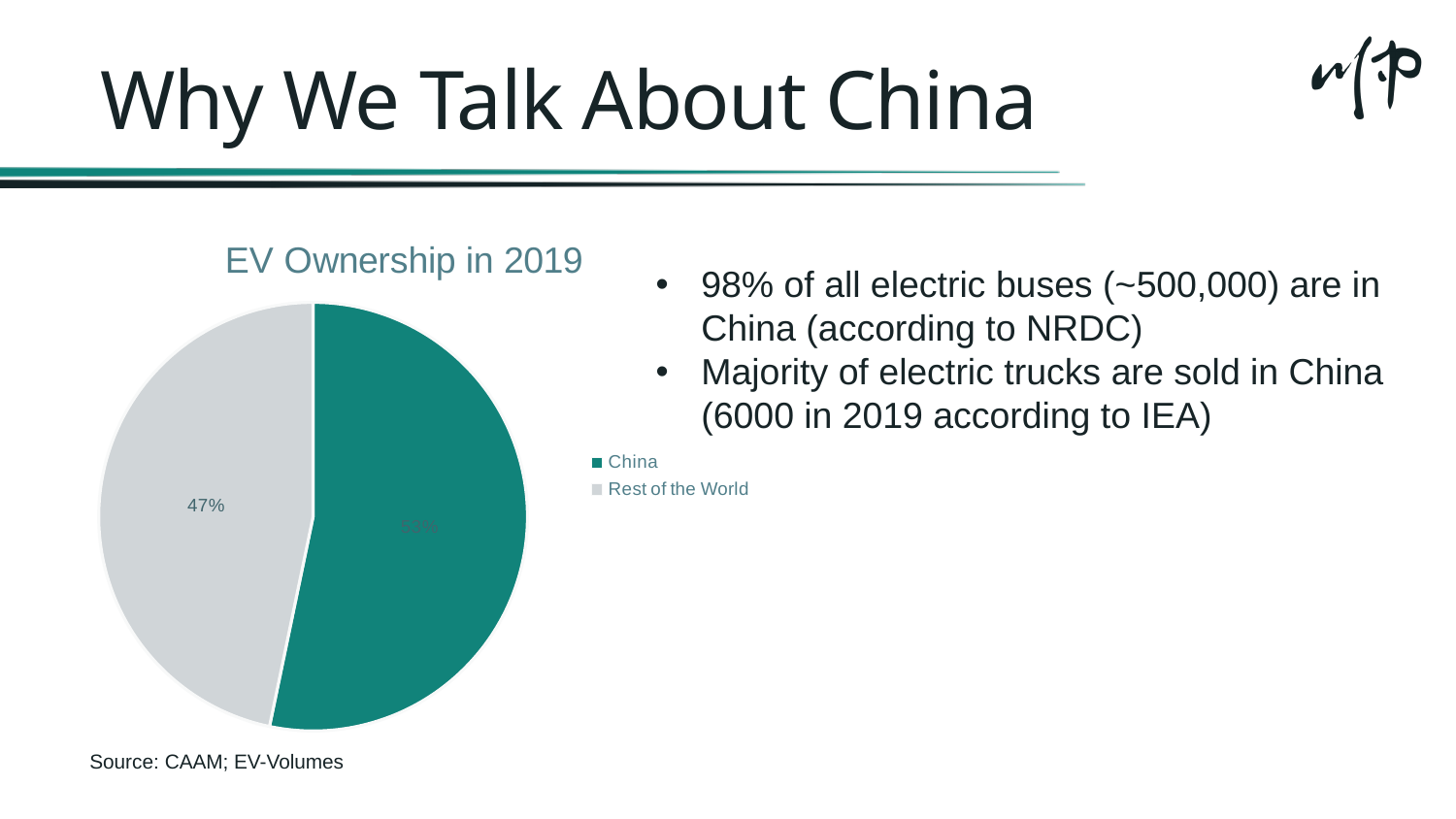
What is the difference between China's share and Rest of the World's share? 6% What kind of chart is shown on the slide? pie chart Which category has the largest share of the pie? China Which legend entry is shown in grey? Rest of the World What share of the pie does China hold? 53% Which category has the smallest share of the pie? Rest of the World Which slice is larger, China or Rest of the World? China How many entries does the legend list? 2 How many slices does the pie chart have? 2 What share of the pie does Rest of the World hold? 47% What is the title of the chart? EV Ownership in 2019